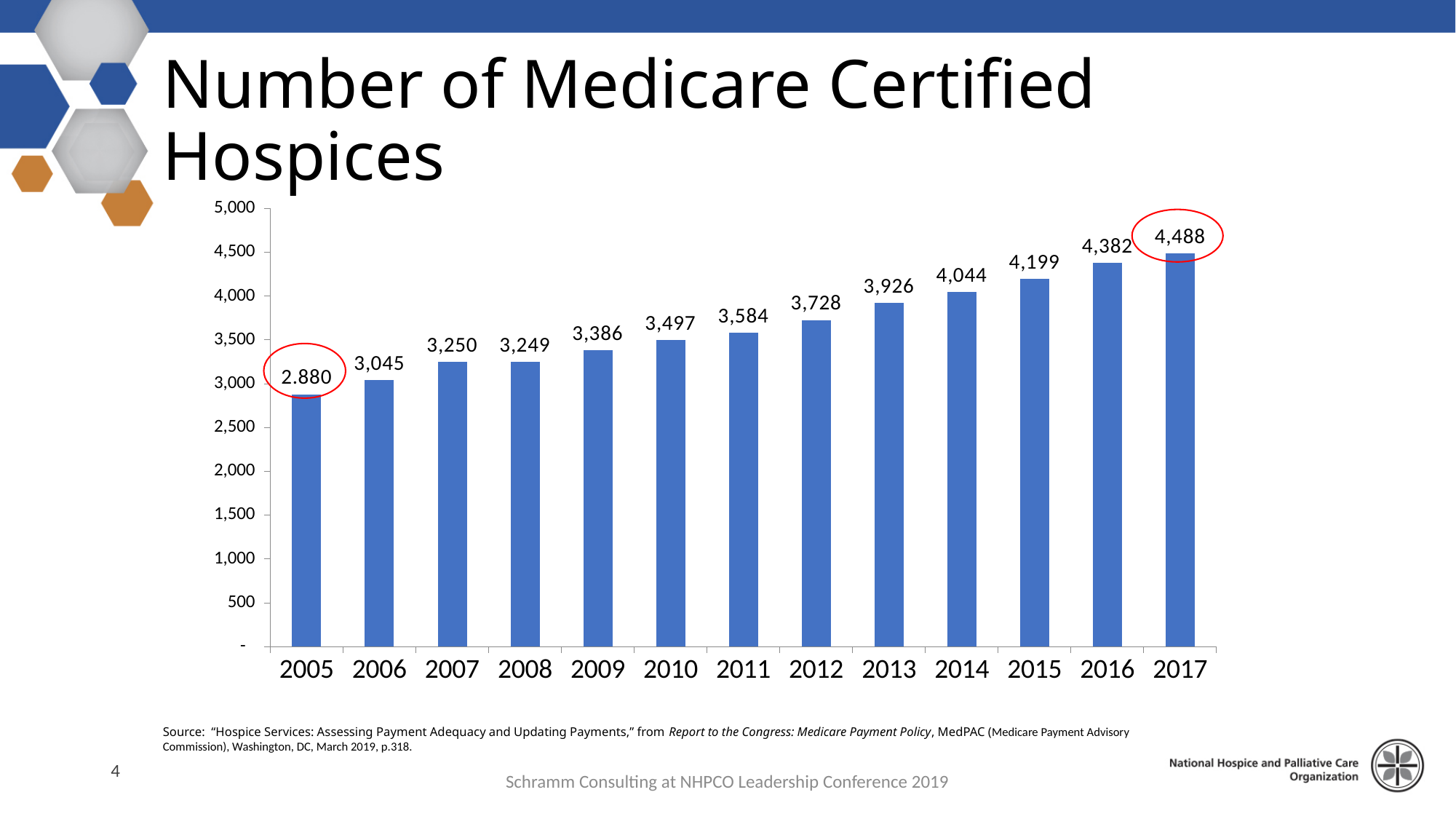
What value is shown for 2016? 4,382 Which year has the lowest number of Medicare certified hospices? 2005 What kind of chart is shown on the slide? bar chart Which is larger, the value for 2011 or the value for 2014? 2014 Do the values generally rise or fall from 2005 to 2017? rise What is the difference between the values for 2017 and 2016? 106 What value is shown for 2009? 3,386 How many years are shown on the x axis? 13 What is the difference between the values for 2013 and 2012? 198 What is the number of Medicare certified hospices shown for 2012? 3,728 Is the value for 2010 greater or less than 3,000? greater Which year has the highest number of Medicare certified hospices? 2017